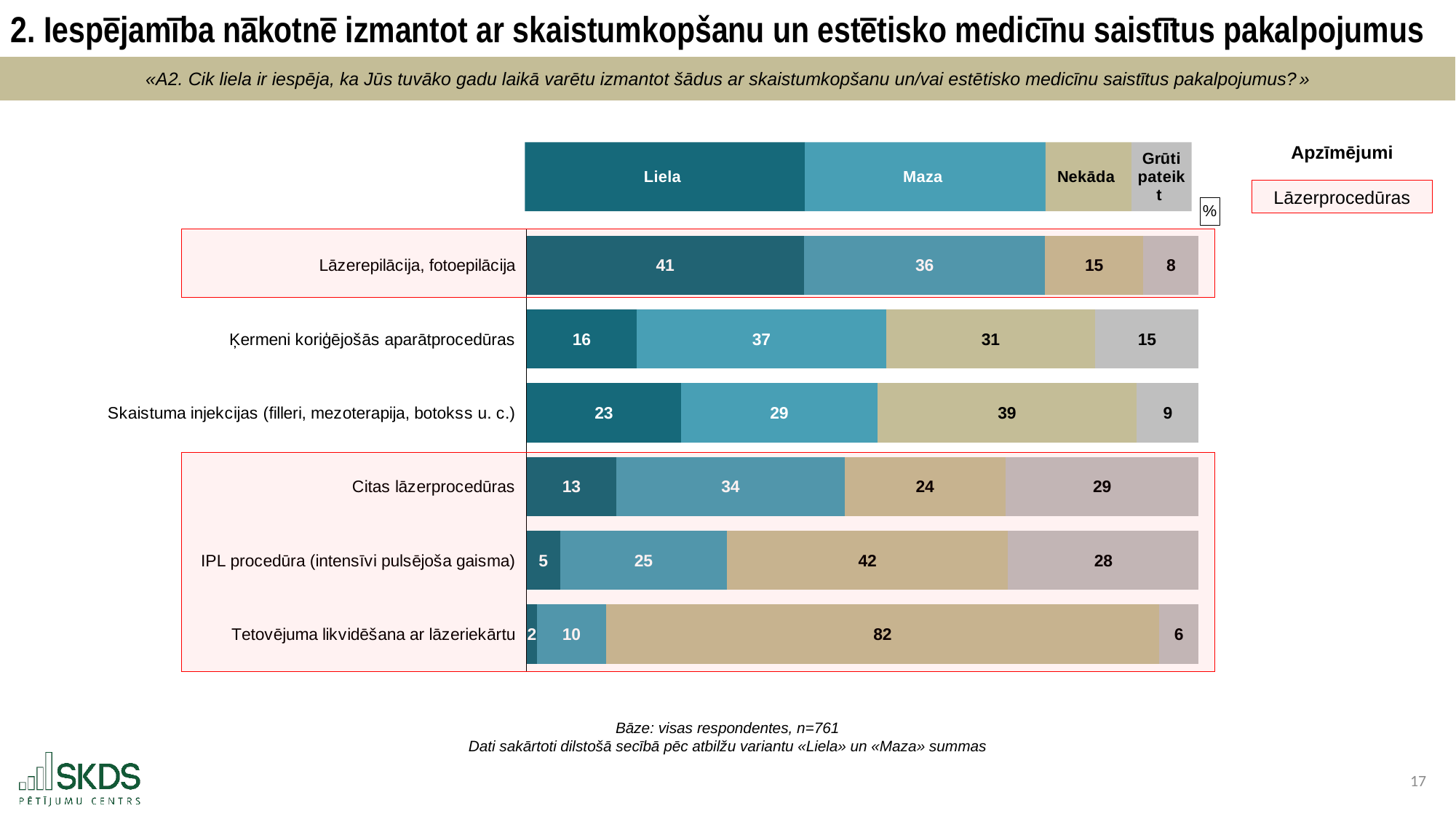
What is the "Grūti pateikt" value for "Citas lāzerprocedūras"? 29 What is the difference between the "Nekāda" values for "IPL procedūra (intensīvi pulsējoša gaisma)" and "Skaistuma injekcijas (filleri, mezoterapija, botokss u. c.)"? 3 Which category has the highest "Liela" value? Lāzerepilācija, fotoepilācija Which is larger: the "Maza" value for "Citas lāzerprocedūras" or the "Maza" value for "IPL procedūra (intensīvi pulsējoša gaisma)"? Citas lāzerprocedūras What kind of chart is shown on the slide? Stacked bar chart What is the "Maza" value for "Ķermeni koriģējošās aparātprocedūras"? 37 How many series does the chart legend list? 4 Which category has the lowest "Liela" value? Tetovējuma likvidēšana ar lāzeriekārtu What is the "Nekāda" value for "Tetovējuma likvidēšana ar lāzeriekārtu"? 82 What is the "Liela" value for "Lāzerepilācija, fotoepilācija"? 41 How many categories (service types) are shown in the chart? 6 What is the combined "Liela" and "Maza" value for "Skaistuma injekcijas (filleri, mezoterapija, botokss u. c.)"? 52